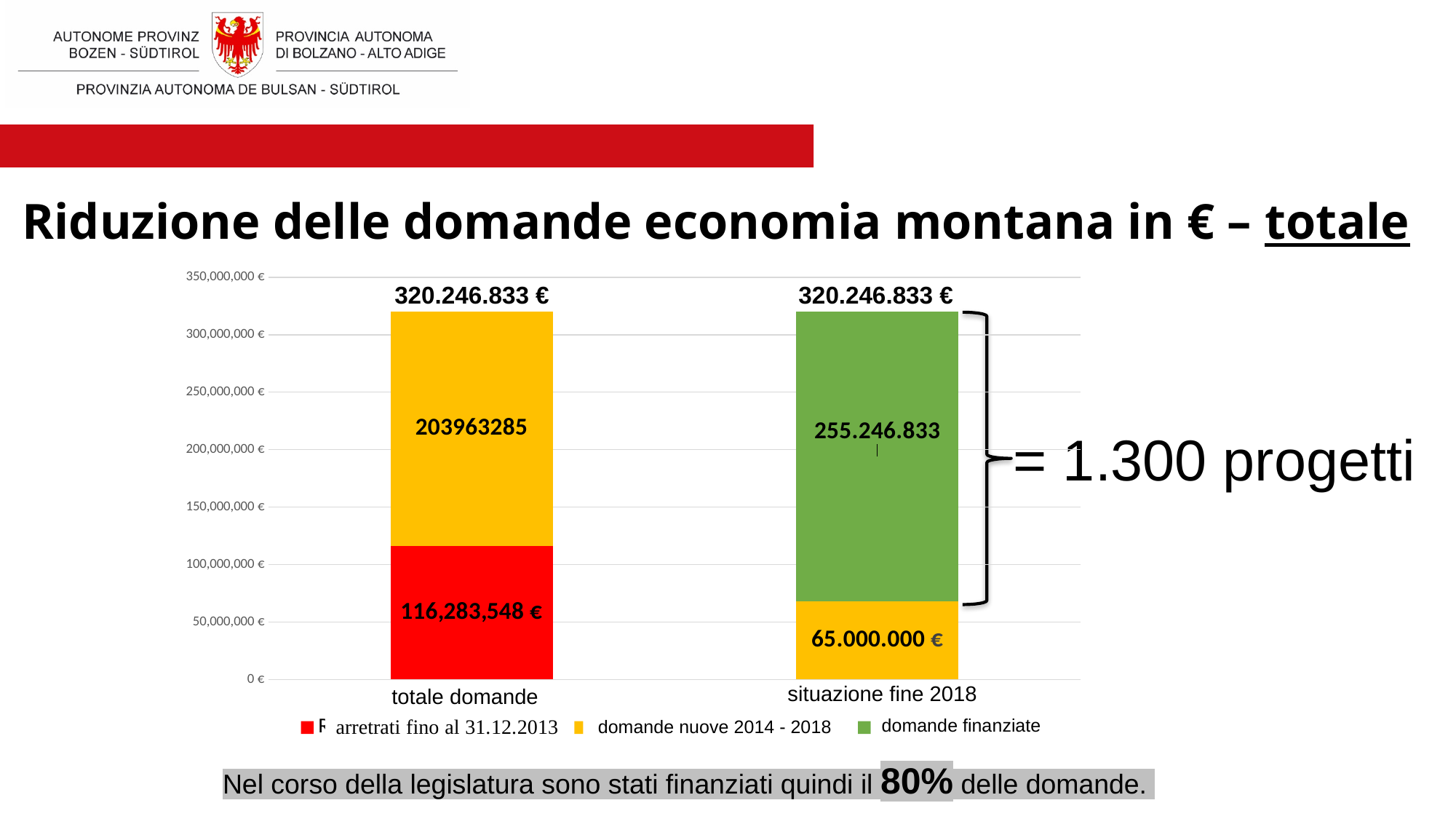
Which colour represents 'domande finanziate' in the legend? green How many bars (categories) does the chart show? 2 What is the value of the red segment (arretrati fino al 31.12.2013) in the 'totale domande' bar? 116,283,548 € How many series does the legend list? 3 Is the red segment (arretrati fino al 31.12.2013) in the 'totale domande' bar greater or less than 100,000,000 €? greater What is the total shown above the 'totale domande' bar? 320.246.833 € What is the value of the yellow segment in the 'situazione fine 2018' bar? 65.000.000 € What is the total shown above the 'situazione fine 2018' bar? 320.246.833 € What kind of chart is shown on the slide? stacked bar chart Which segment is larger in the 'situazione fine 2018' bar: the green 'domande finanziate' or the yellow segment? domande finanziate What is the value of the yellow segment (domande nuove 2014 - 2018) in the 'totale domande' bar? 203963285 What is the value of the green segment (domande finanziate) in the 'situazione fine 2018' bar? 255.246.833